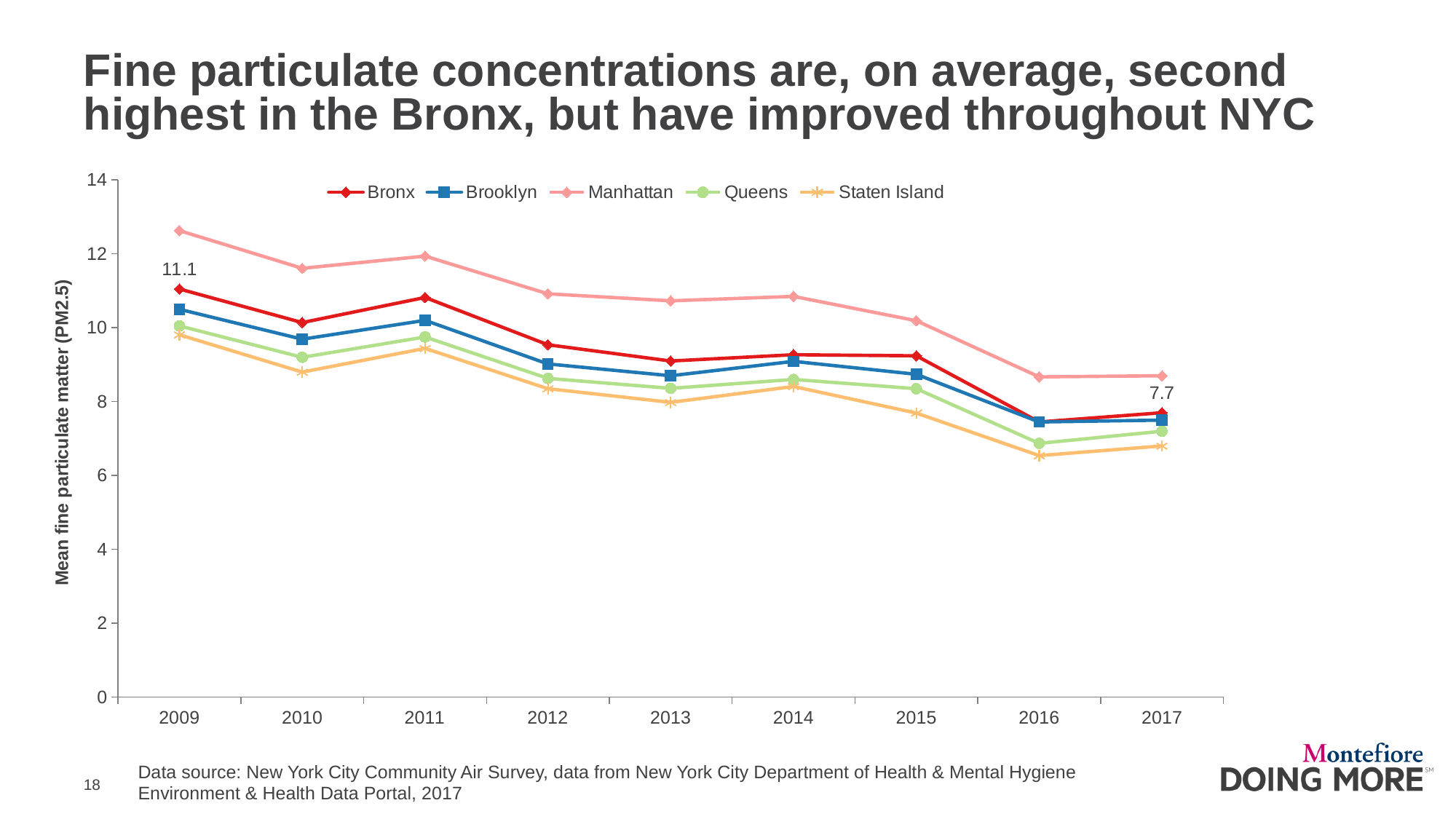
What kind of chart is shown on the slide? Line chart Is the value for Manhattan in 2009 greater or less than 12? greater Which borough has the lowest value in 2017? Staten Island What is the value for the Bronx in 2009? 11.1 By how much did the Bronx value fall from 2009 to 2017? 3.4 Does the Bronx line rise or fall overall from 2009 to 2017? Fall How many series does the legend list? 5 Which borough has the highest value in 2009? Manhattan In 2012, which is larger, the value for Manhattan or the value for Queens? Manhattan Is the value for Staten Island in 2016 greater or less than 8? less What is the value for the Bronx in 2017? 7.7 How many years are shown on the x axis? 9